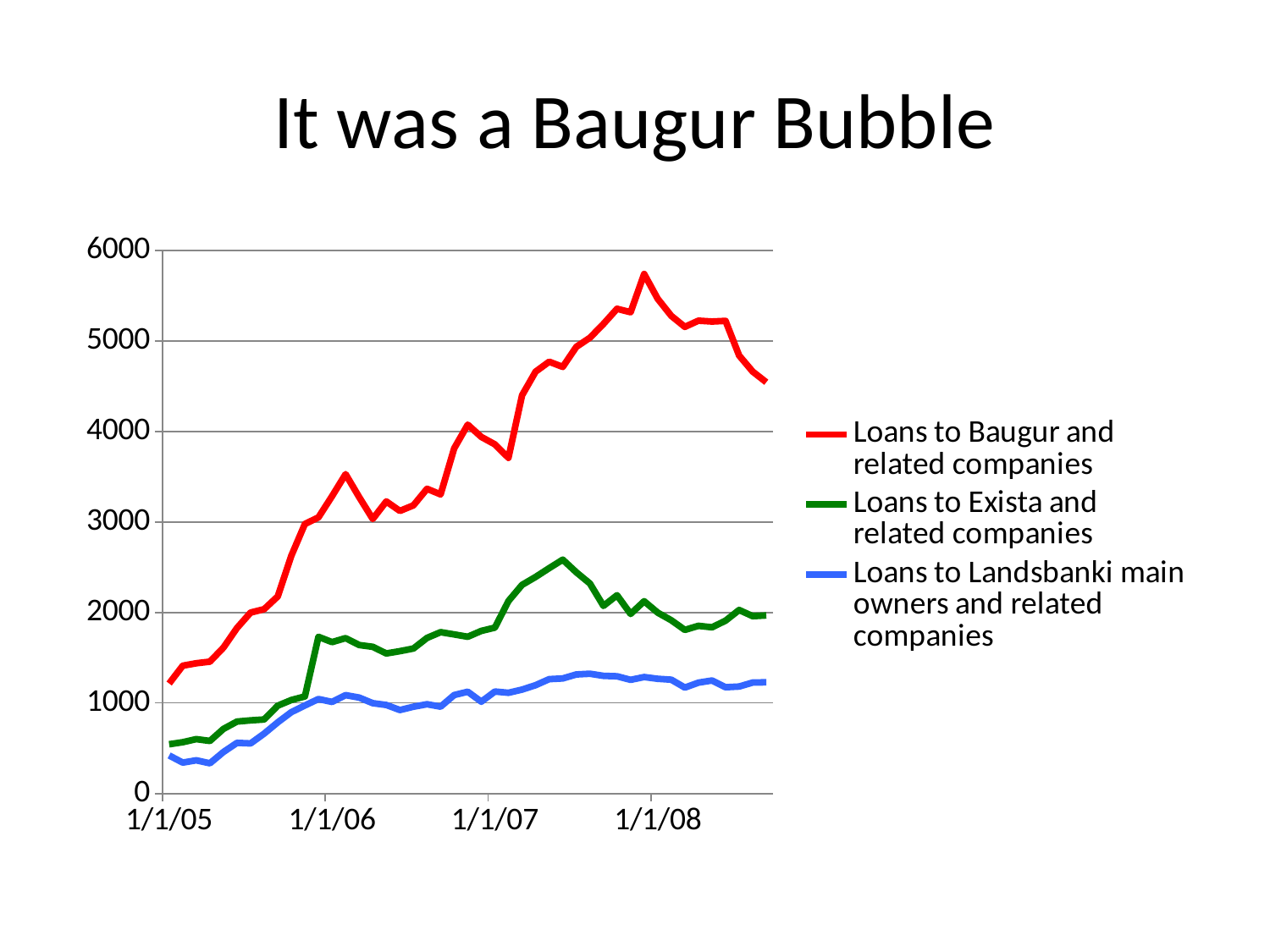
Is the value for Loans to Exista and related companies at 1/1/05 greater or less than 1000? less What kind of chart is shown on the slide? line chart How many series does the legend list? 3 At 1/1/06, which is larger: Loans to Exista and related companies or Loans to Landsbanki main owners and related companies? Loans to Exista and related companies Which series has the highest values at 1/1/08? Loans to Baugur and related companies Is the value for Loans to Baugur and related companies at 1/1/05 greater or less than 2000? less What colour is the line for Loans to Exista and related companies? green Is the peak value of Loans to Baugur and related companies greater or less than 5000? greater Do the values for Loans to Baugur and related companies rise or fall between 1/1/05 and 1/1/07? rise What is the title of the slide's chart? It was a Baugur Bubble Which series has the lowest values at 1/1/08? Loans to Landsbanki main owners and related companies